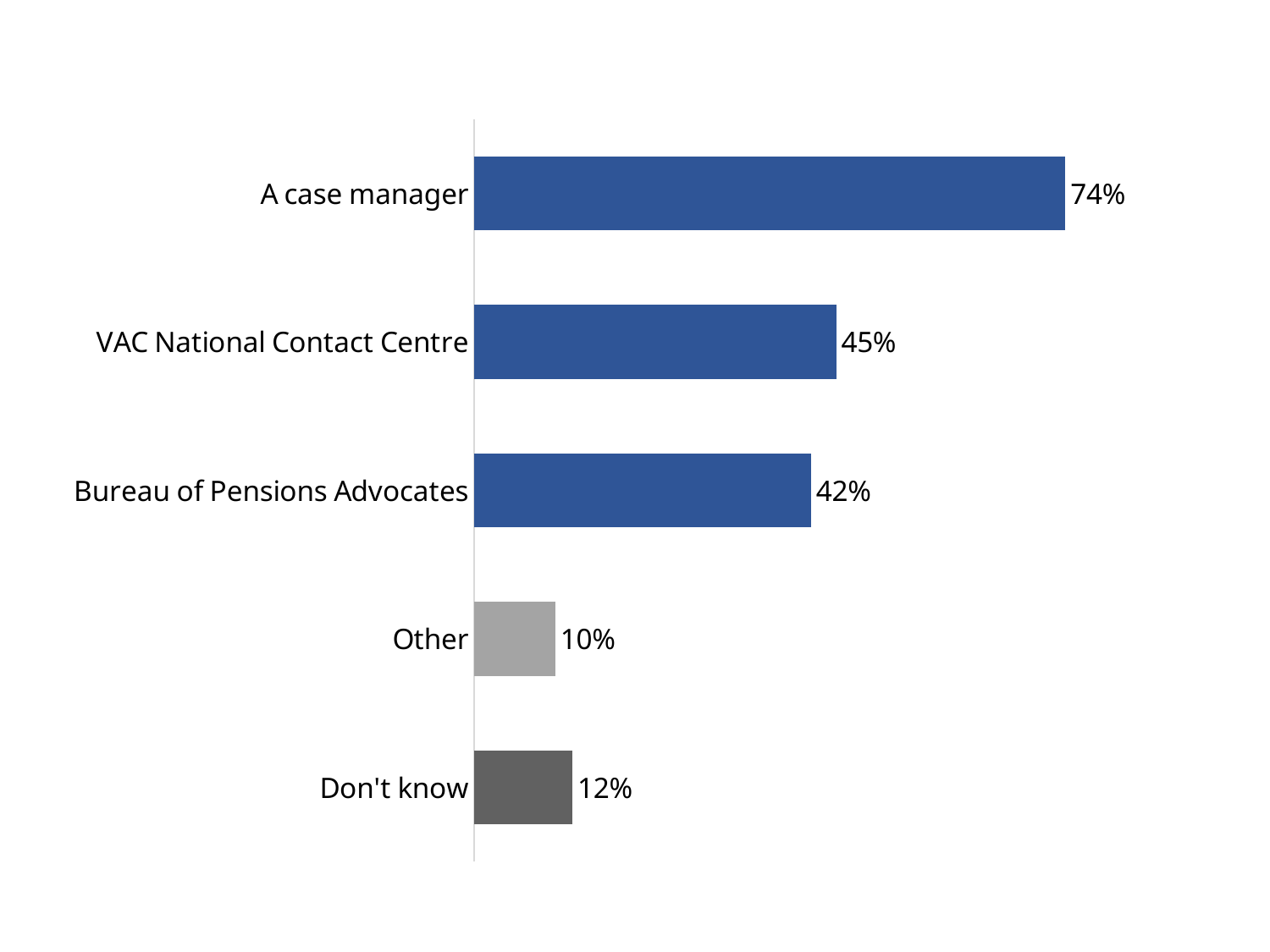
What colour is the bar for Other? Grey Which category has the highest value? A case manager What is the value for VAC National Contact Centre? 45% What is the value for Bureau of Pensions Advocates? 42% Which category has the lowest value? Other What is the difference between the values for Don't know and Other? 2% Which is larger, the value for VAC National Contact Centre or Bureau of Pensions Advocates? VAC National Contact Centre What kind of chart is this? Bar chart What is the value for A case manager? 74% What is the difference between the values for A case manager and VAC National Contact Centre? 29% What is the value for Don't know? 12% How many categories are shown in the chart? 5